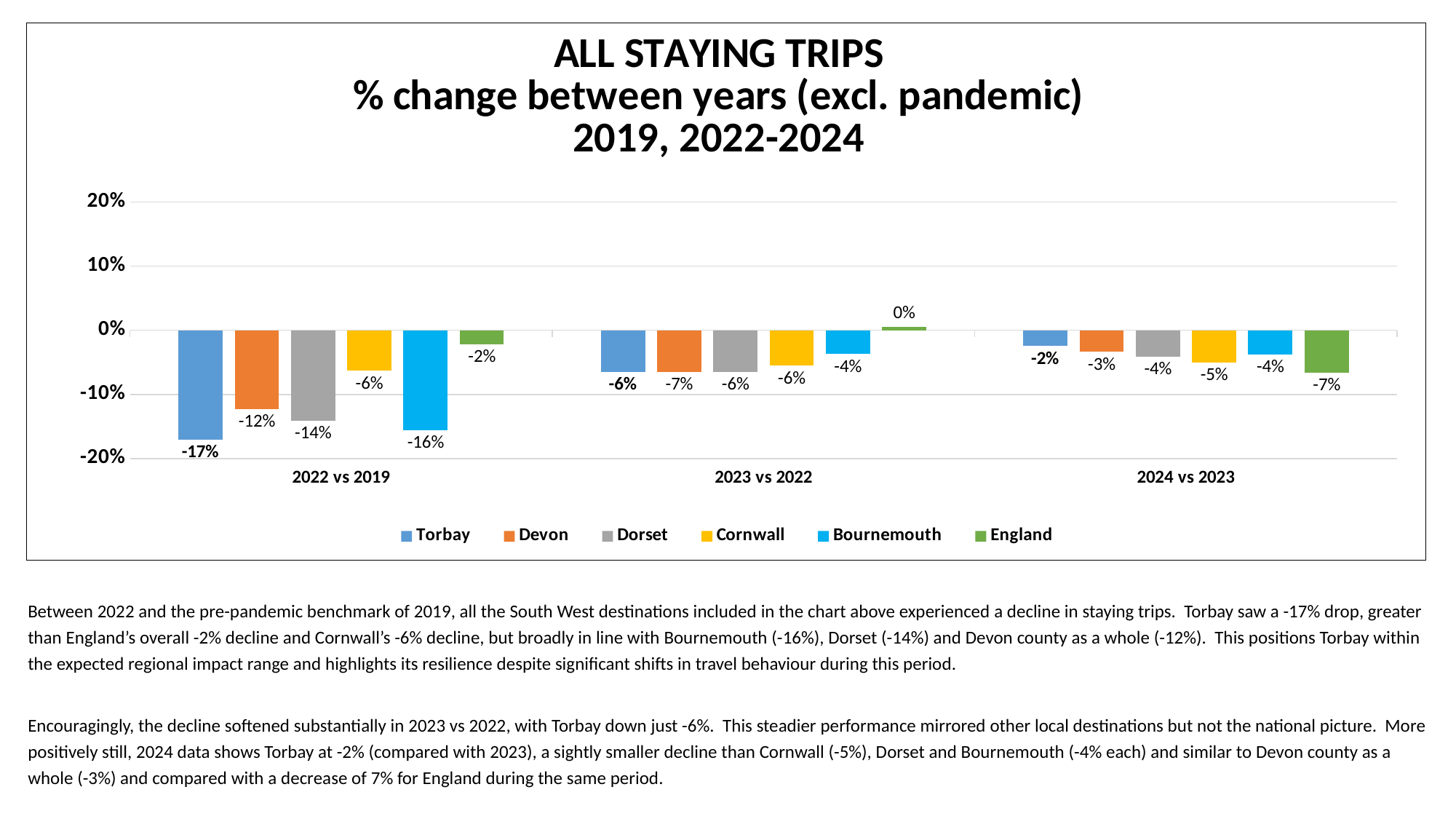
What colour represents Bournemouth in the chart? Light blue What is the value for England in the 2023 vs 2022 group? 0% What is the value for Torbay in the 2022 vs 2019 group? -17% What is the value for Bournemouth in the 2022 vs 2019 group? -16% What is the difference between the Torbay value in 2022 vs 2019 and the Torbay value in 2024 vs 2023? 15 percentage points Which series has the lowest value in the 2024 vs 2023 group? England Which is larger, the Devon value in 2022 vs 2019 or the Devon value in 2023 vs 2022? 2023 vs 2022 Which series has the lowest value in the 2022 vs 2019 group? Torbay How many category groups are shown on the x axis? 3 What is the value for Cornwall in the 2024 vs 2023 group? -5% How many series does the legend list? 6 What kind of chart is this? Bar chart